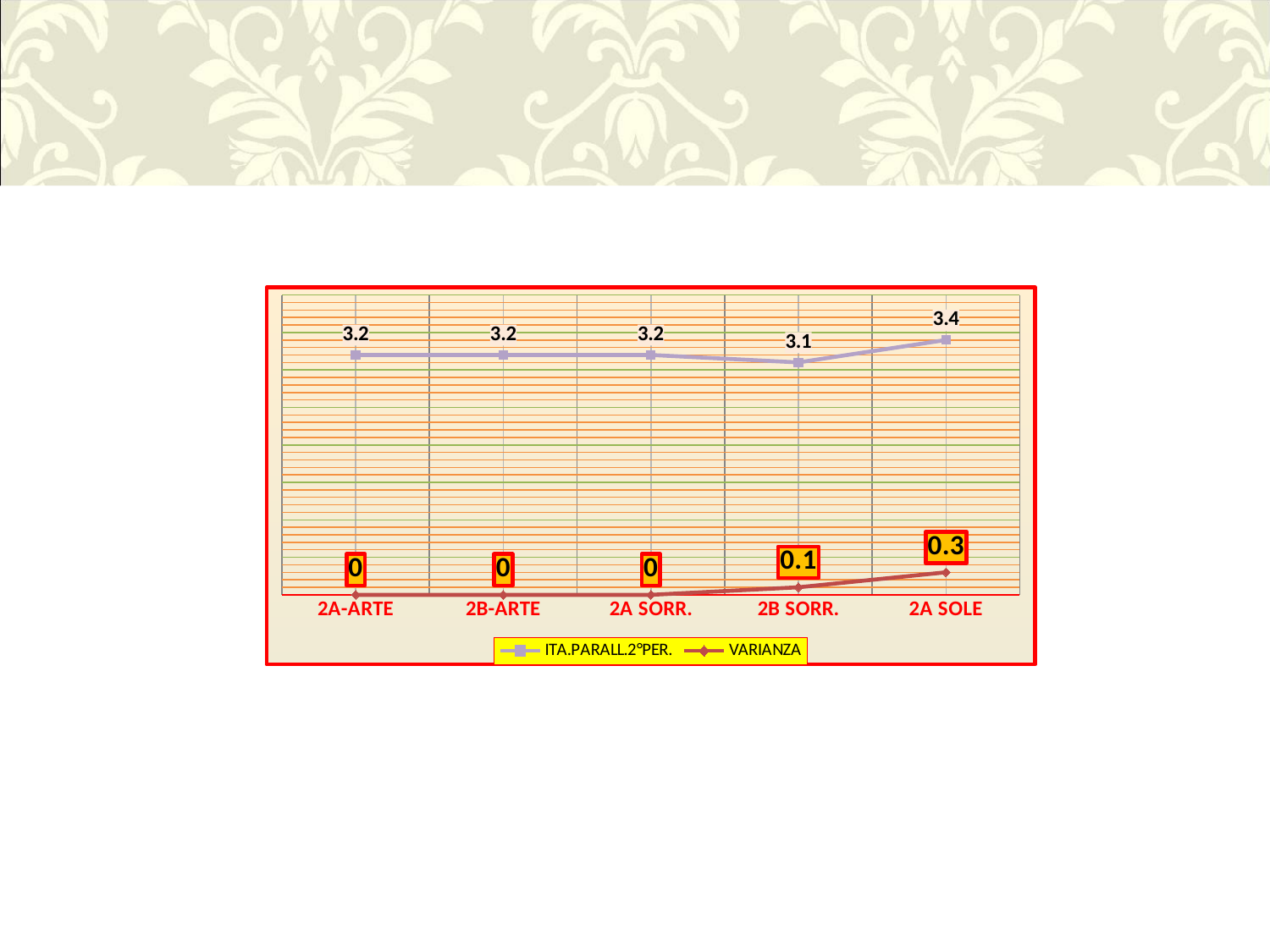
What is the VARIANZA value for 2B SORR.? 0.1 What is the ITA.PARALL.2°PER. value for 2B SORR.? 3.1 What is the difference between the ITA.PARALL.2°PER. values for 2A SOLE and 2B SORR.? 0.3 How many series does the legend list? 2 How many categories are shown on the x axis? 5 Which category has the lowest ITA.PARALL.2°PER. value? 2B SORR. Which is larger, the VARIANZA value for 2A SOLE or for 2B SORR.? 2A SOLE What kind of chart is this? Line chart Does the VARIANZA series rise or fall from 2A SORR. to 2A SOLE? Rise Which category has the highest ITA.PARALL.2°PER. value? 2A SOLE What is the VARIANZA value for 2A SOLE? 0.3 What is the ITA.PARALL.2°PER. value for 2A SOLE? 3.4